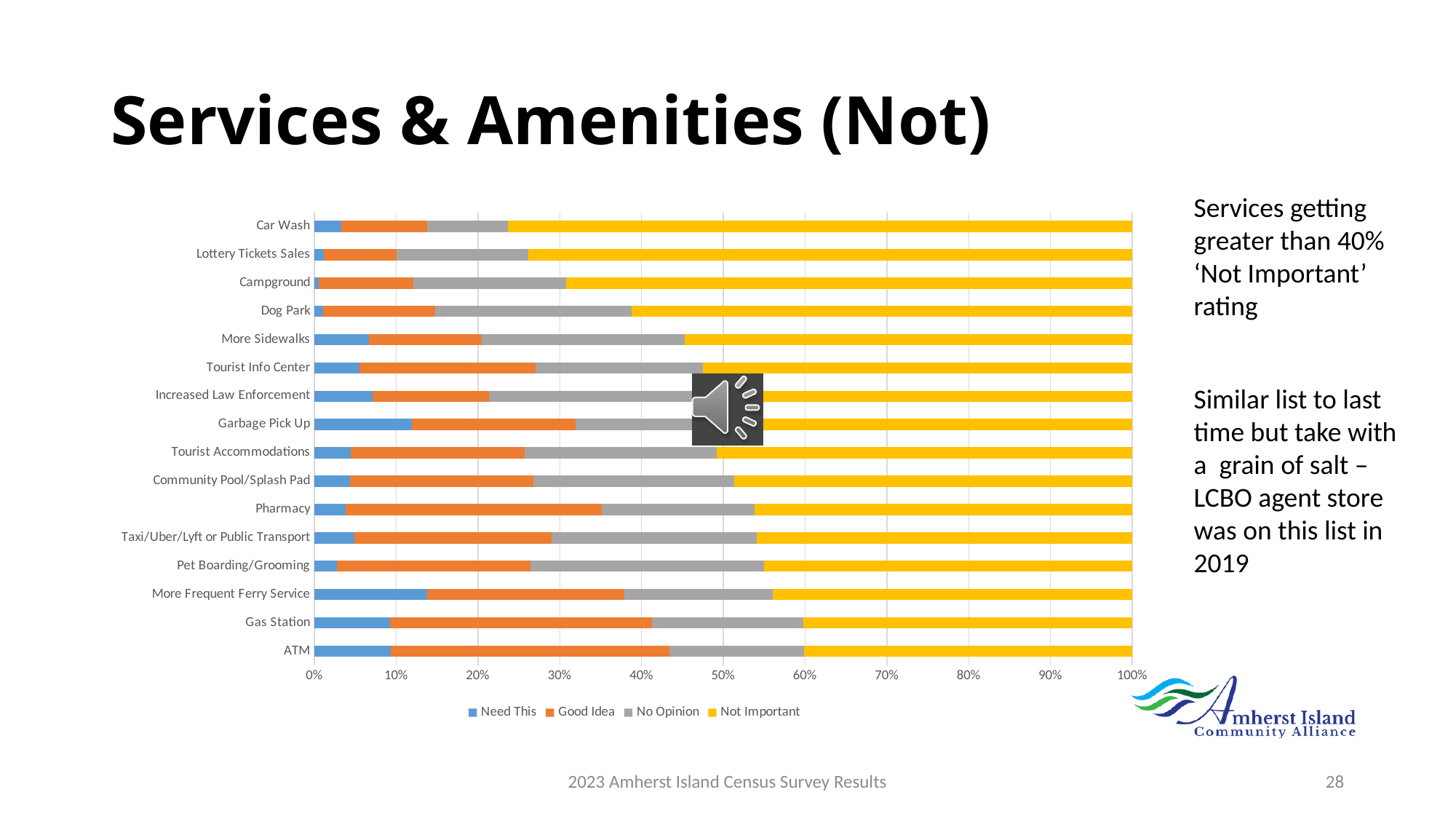
Which has the larger 'Not Important' share, Car Wash or ATM? Car Wash Which service has the largest 'Not Important' share in the chart? Car Wash Is the 'Not Important' share for Car Wash greater or less than 70%? greater Which colour represents the 'Not Important' series in the chart? Yellow Is the 'Not Important' share for Dog Park greater or less than 50%? greater Which has the larger 'Need This' share, Garbage Pick Up or Campground? Garbage Pick Up What kind of chart is shown on the slide? Stacked bar chart How many services or amenities are listed on the chart? 16 What are the four series named in the chart legend? Need This, Good Idea, No Opinion, Not Important Is the 'Need This' share for Campground greater or less than 10%? less How many series does the chart legend list? 4